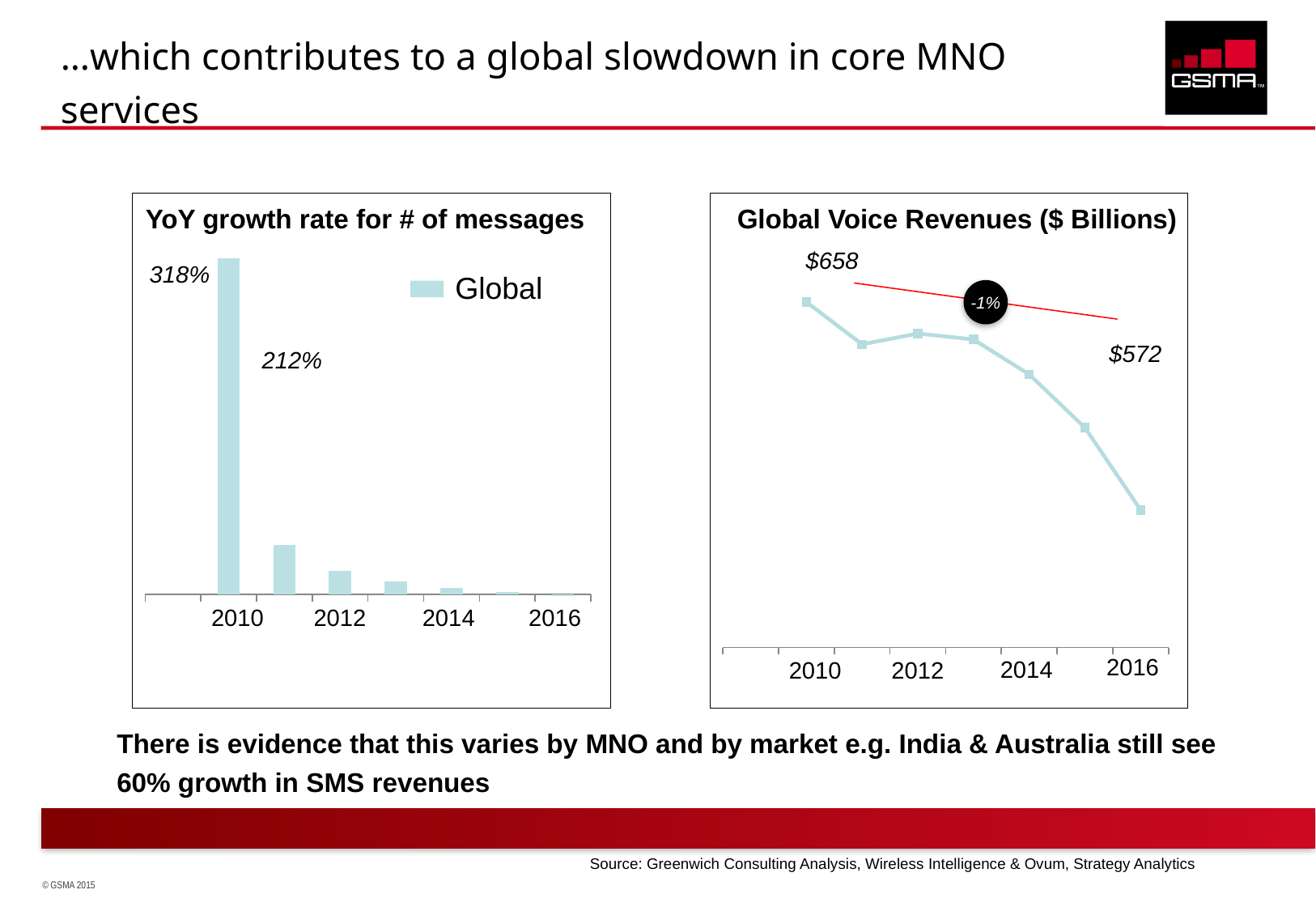
In the 'Global Voice Revenues ($ Billions)' chart, do the values generally rise or fall from 2010 to 2016? fall In the 'YoY growth rate for # of messages' chart, do the values rise or fall from 2010 to 2016? fall In the 'YoY growth rate for # of messages' chart, what is the growth rate labelled for 2010? 318% What type of chart is the 'YoY growth rate for # of messages' chart? bar chart In the 'YoY growth rate for # of messages' chart, which is larger, the value for 2010 or the value for 2011? 2010 What type of chart is the 'Global Voice Revenues ($ Billions)' chart? line chart In the 'Global Voice Revenues ($ Billions)' chart, which year has the lowest value? 2016 What is the legend entry shown in the 'YoY growth rate for # of messages' chart? Global In the 'Global Voice Revenues ($ Billions)' chart, what is the value labelled for 2010? $658 In the 'YoY growth rate for # of messages' chart, how many series does the legend list? 1 In the 'YoY growth rate for # of messages' chart, which year has the highest growth rate? 2010